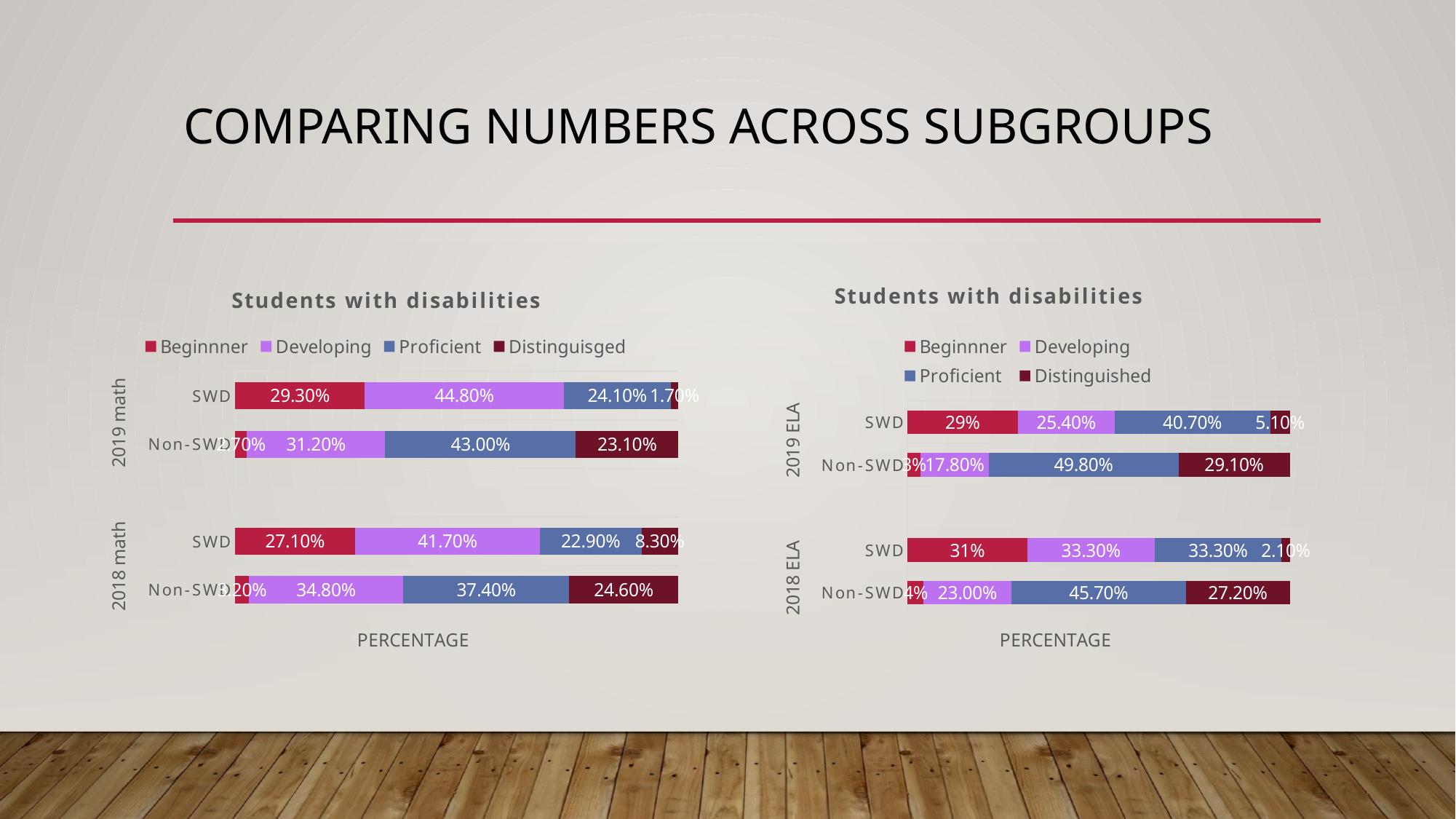
What kind of chart is the left chart (math)? Stacked bar chart In the right chart (ELA), what is the Beginner percentage for SWD in 2018 ELA? 31% In the left chart (math), what is the difference between the Distinguished percentage for Non-SWD and SWD in 2019 math? 21.40% How many series does the legend of the right chart (ELA) list? 4 In the left chart (math), what is the Distinguished percentage for SWD in 2018 math? 8.30% In the left chart (math), what is the Developing percentage for SWD in 2019 math? 44.80% In the right chart (ELA), what is the Proficient percentage for Non-SWD in 2019 ELA? 49.80% In the right chart (ELA), what is the Distinguished percentage for Non-SWD in 2018 ELA? 27.20% In the right chart (ELA), which is larger for SWD in 2019 ELA: the Developing percentage or the Proficient percentage? Proficient In the right chart (ELA), which performance level has the lowest percentage for SWD in 2018 ELA? Distinguished In the left chart (math), what is the Proficient percentage for Non-SWD in 2019 math? 43.00% In the left chart (math), which performance level has the highest percentage for SWD in 2018 math? Developing